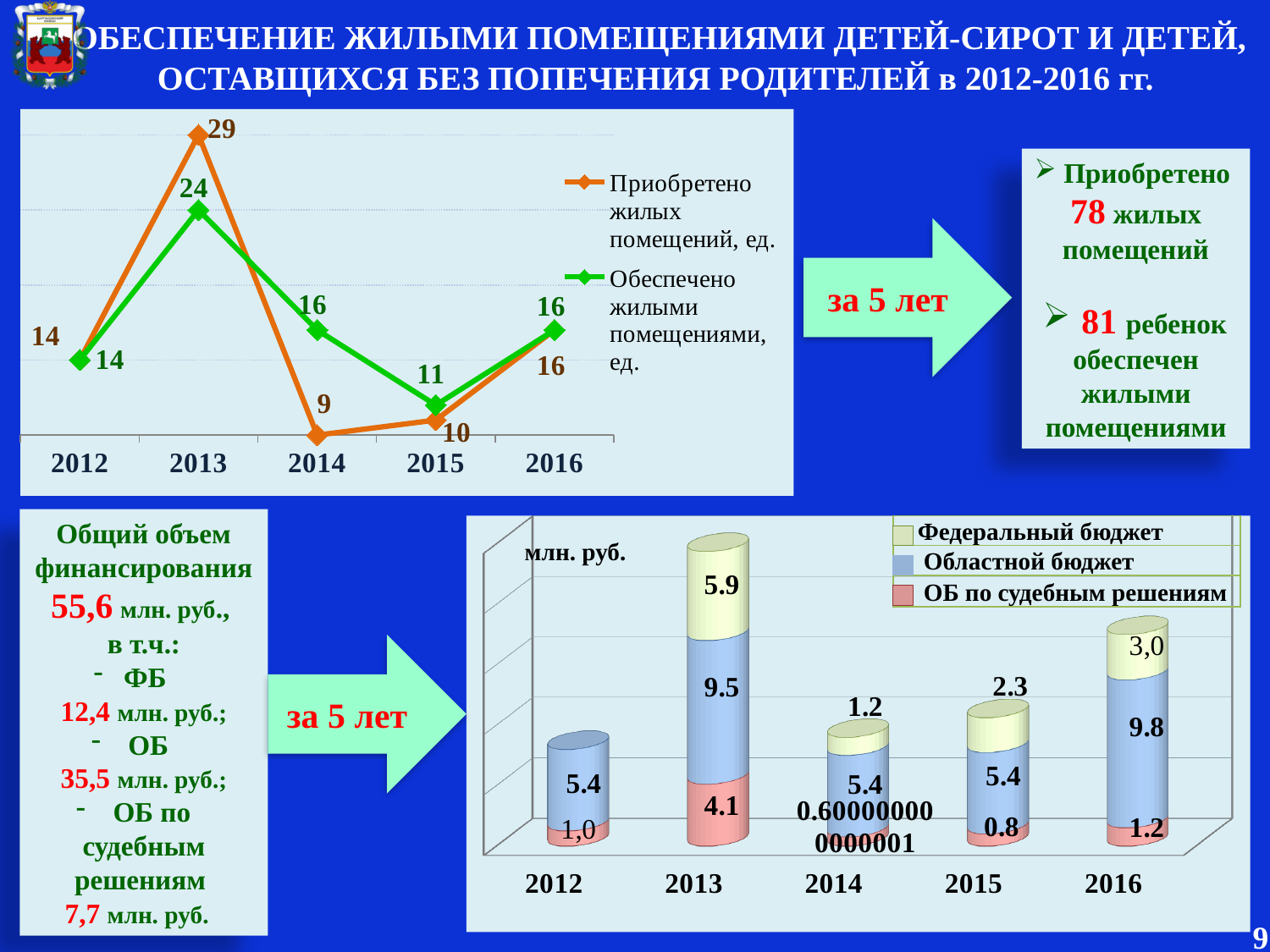
In the bottom stacked bar chart, what is the value of 'Областной бюджет' for 2016? 9.8 In the top line chart, does the 'Приобретено жилых помещений, ед.' series rise or fall from 2013 to 2014? fall In the top line chart, in which year is the 'Приобретено жилых помещений, ед.' series lowest? 2014 In the bottom stacked bar chart, what is the total of the 2013 bar? 19.5 In the top line chart, what is the difference between the two series in 2014? 7 In the top line chart, what is the value of the 'Обеспечено жилыми помещениями, ед.' series for 2014? 16 In the top line chart, which series has the larger value in 2015? Обеспечено жилыми помещениями, ед. In the top line chart, what is the value of the 'Приобретено жилых помещений, ед.' series for 2013? 29 What kind of chart is the bottom chart? stacked bar chart In the bottom stacked bar chart, which year has the highest 'Федеральный бюджет' value? 2013 How many years are shown on the x axis of the bottom stacked bar chart? 5 How many series does the legend of the top line chart list? 2